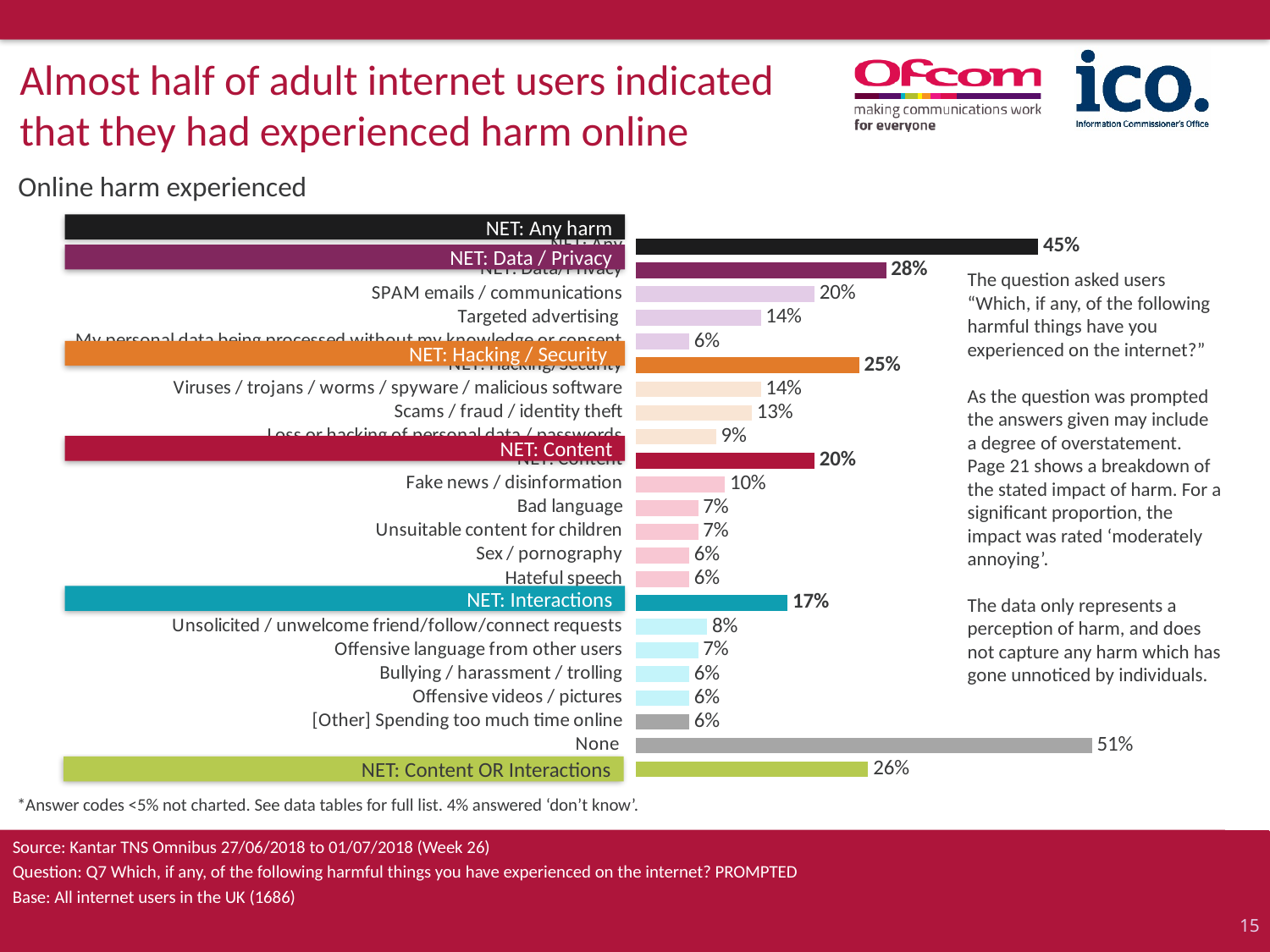
What percentage of adult internet users indicated they had experienced any harm online (NET: Any harm)? 45% What is the value for NET: Hacking / Security? 25% What type of chart is shown on the slide? Bar chart What is the difference between the value for None and the value for NET: Any harm? 6% What is the value for NET: Content OR Interactions? 26% What is the difference between NET: Data / Privacy and NET: Interactions? 11% Which category has the highest value in the chart? None What is the value for SPAM emails / communications? 20% Which is larger, the value for Targeted advertising or the value for Unsolicited / unwelcome friend/follow/connect requests? Targeted advertising What percentage of users reported experiencing fake news / disinformation? 10% What is the title of the chart? Online harm experienced What is the value for Scams / fraud / identity theft? 13%